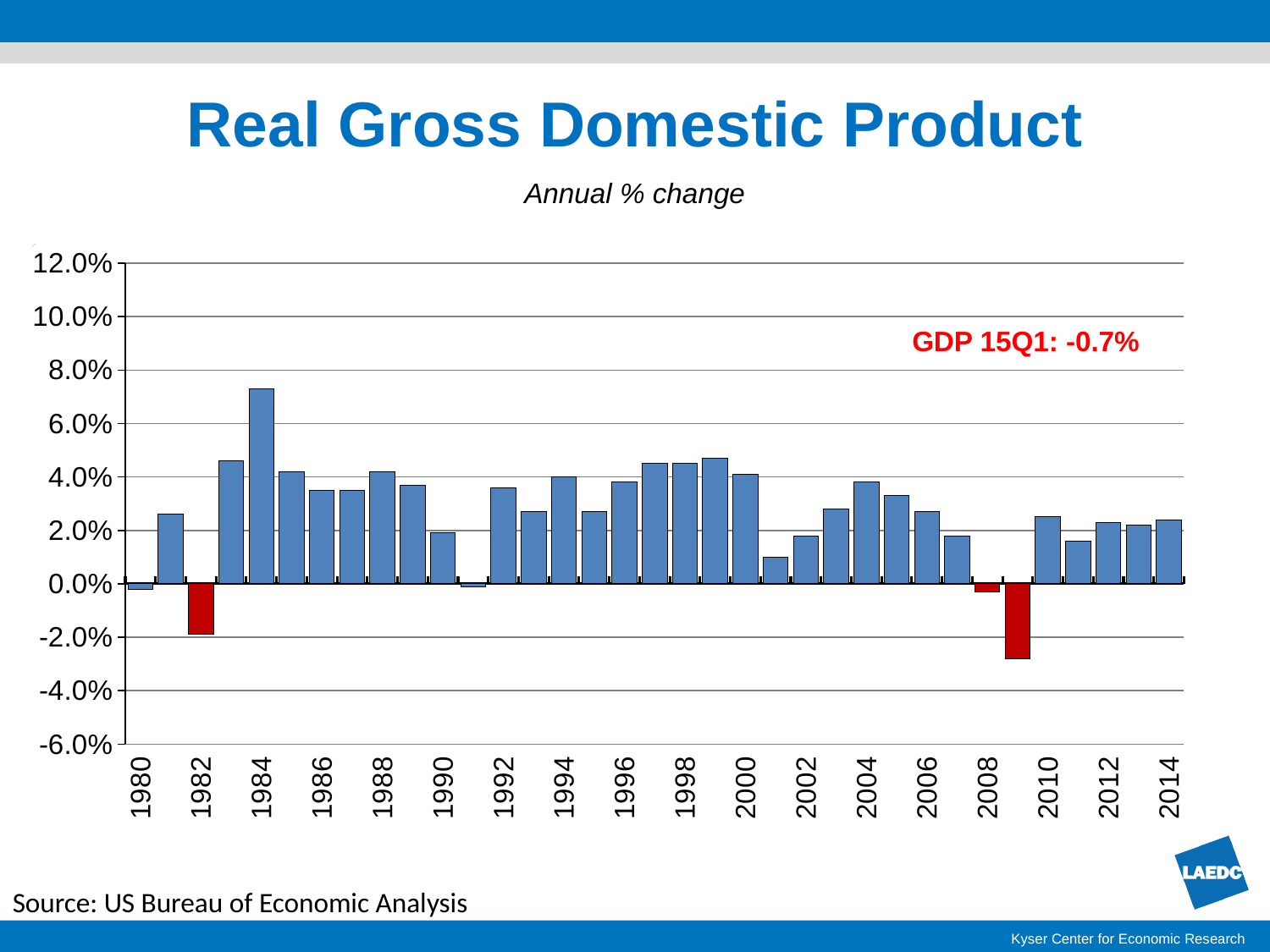
Do the values rise or fall from 2004 to 2009? fall How many years (bars) are plotted on the chart? 35 Which year has the lowest annual % change in real GDP? 2009 Is the value for 2001 greater or less than 2.0%? less Is the value for 2009 greater or less than -2.0%? less What value does the red annotation on the chart give for GDP 15Q1? -0.7% Which year has the larger value, 1983 or 1984? 1984 Which year has the highest annual % change in real GDP? 1984 What kind of chart is shown on the slide? bar chart Is the value for 1984 greater or less than 6.0%? greater What is the title of the chart? Real Gross Domestic Product